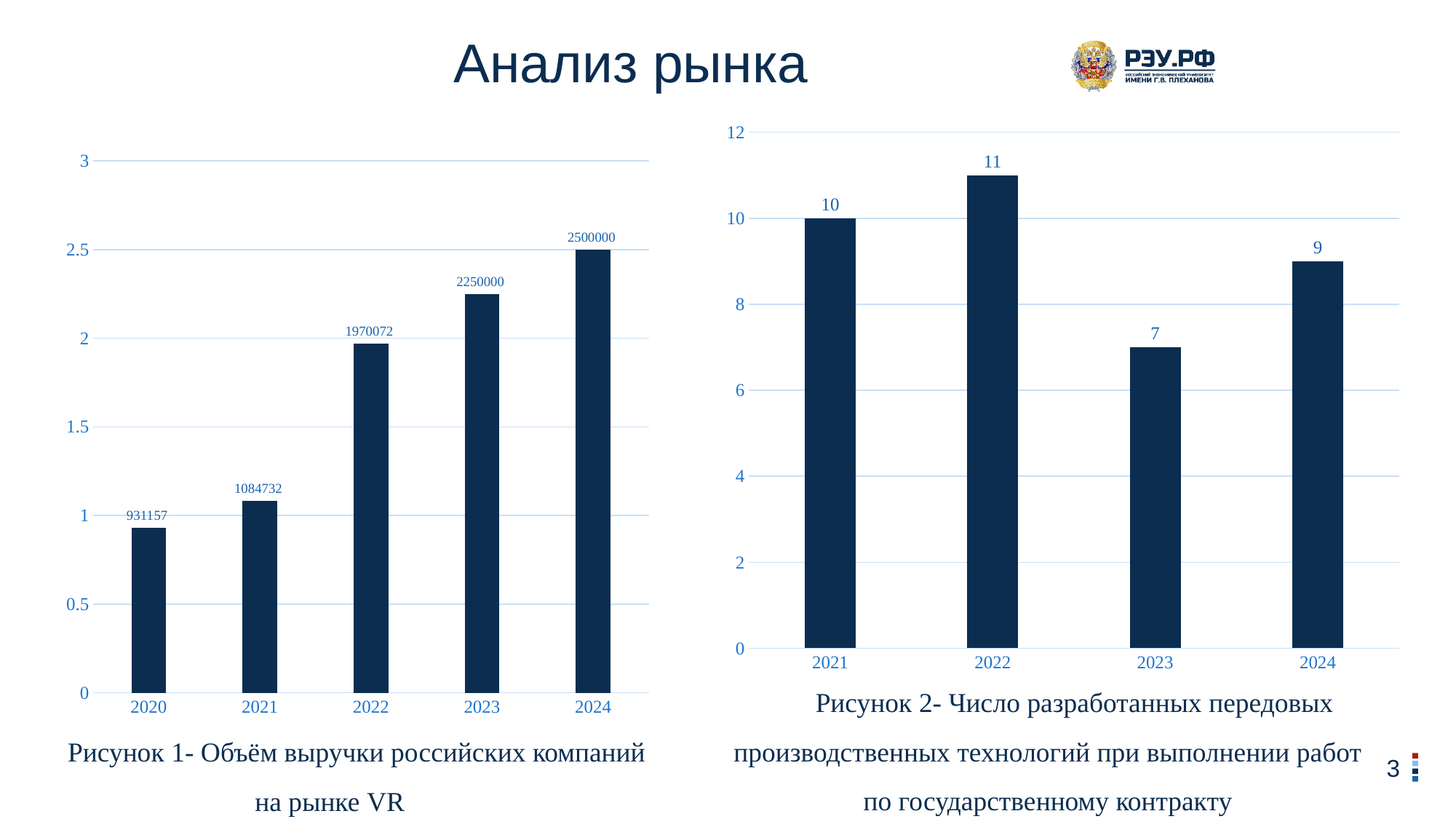
In the left chart (Рисунок 1), do the values rise or fall from 2020 to 2024? rise In the left chart (Рисунок 1), what is the difference between the values for 2024 and 2023? 250000 What type of chart is the right chart (Рисунок 2)? bar chart In the left chart (Рисунок 1), which year has the highest value? 2024 In the right chart (Рисунок 2), which year has the highest value? 2022 In the left chart (Рисунок 1), what is the value for 2020? 931157 In the right chart (Рисунок 2), what is the difference between the values for 2022 and 2023? 4 In the left chart (Рисунок 1), which year has the lowest value? 2020 In the right chart (Рисунок 2), which is larger, the value for 2021 or the value for 2024? 2021 How many years are shown on the x axis of the left chart (Рисунок 1)? 5 In the right chart (Рисунок 2), what is the value for 2023? 7 In the left chart (Рисунок 1), what is the value for 2022? 1970072